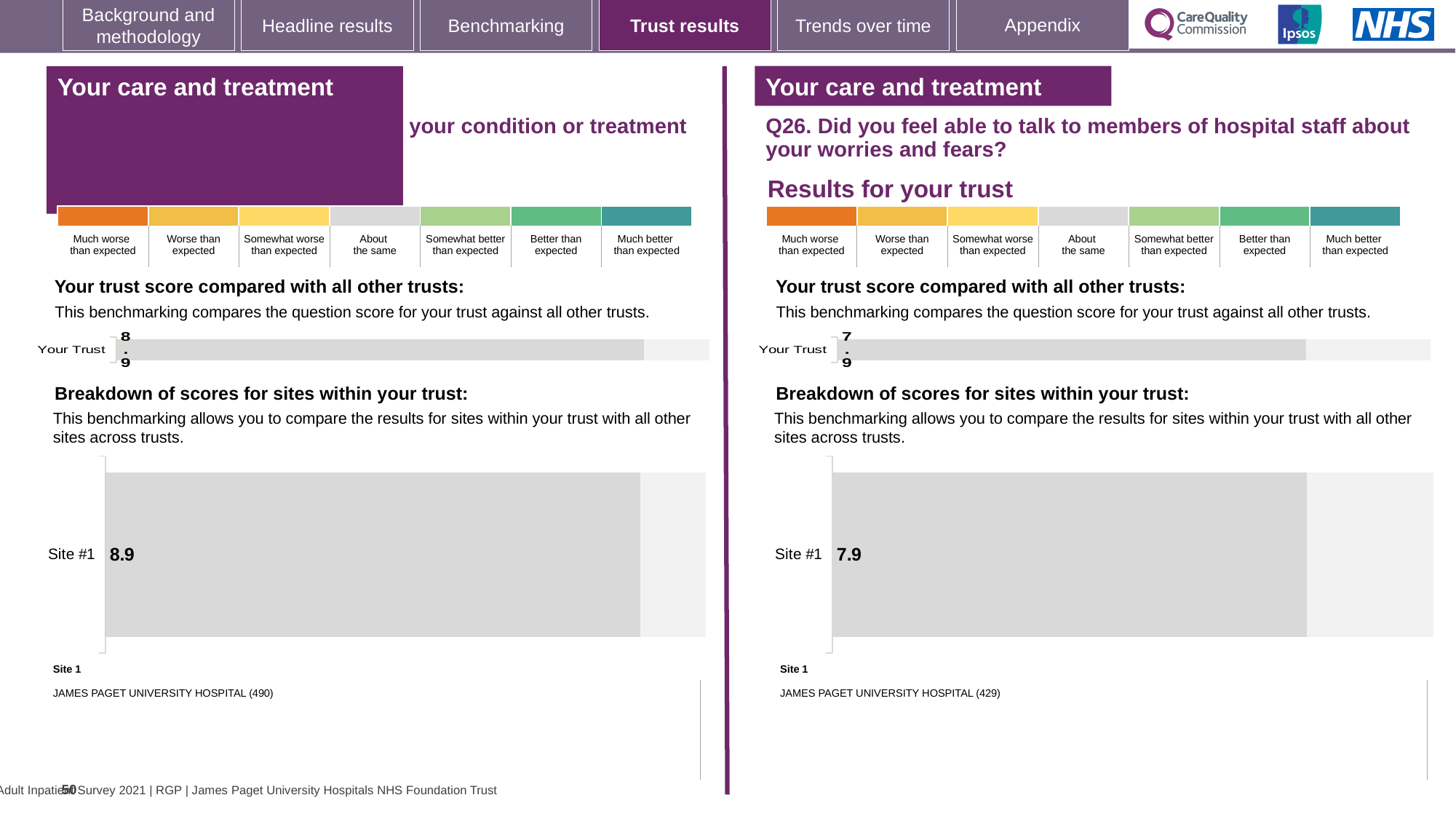
What is the difference between the Your Trust score in the left-hand chart (8.9) and the Your Trust score in the right-hand Q26 chart (7.9)? 1.0 In the left-hand 'Your trust score compared with all other trusts' chart, what is the value for Your Trust? 8.9 How many sites are shown in the left-hand 'Breakdown of scores for sites within your trust' chart? 1 What kind of chart is used to show the Site #1 score in the right-hand breakdown section? Bar chart Is the Your Trust score in the right-hand Q26 chart greater or less than the Your Trust score in the left-hand chart? less In the right-hand Q26 'Breakdown of scores for sites within your trust' chart, what is the score for Site #1? 7.9 What number appears in parentheses after the Site 1 hospital name below the right-hand Q26 breakdown chart? 429 Which hospital is listed as Site 1 below the left-hand breakdown chart? JAMES PAGET UNIVERSITY HOSPITAL How many bars are plotted in the right-hand Q26 'Your trust score compared with all other trusts' chart? 1 In the left-hand 'Breakdown of scores for sites within your trust' chart, what is the score for Site #1? 8.9 In the right-hand Q26 'Your trust score compared with all other trusts' chart, what is the value for Your Trust? 7.9 Which is larger: the Site #1 score in the left-hand breakdown chart or the Site #1 score in the right-hand Q26 breakdown chart? The left-hand chart (8.9)